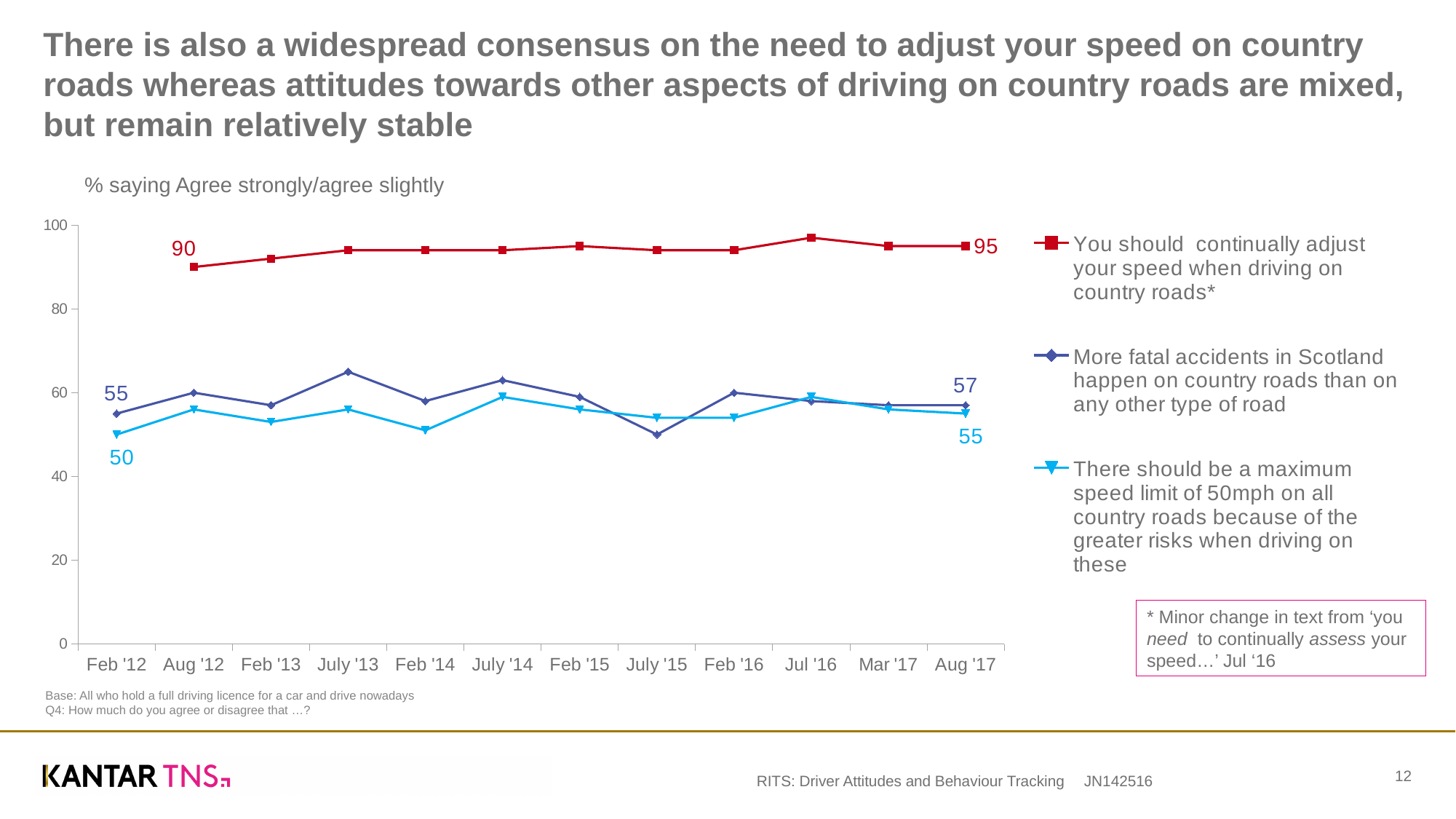
What value does the 'More fatal accidents in Scotland happen on country roads' series have at Aug '17? 57 What value does the 'There should be a maximum speed limit of 50mph on all country roads' series have at Aug '17? 55 What value does the 'There should be a maximum speed limit of 50mph on all country roads' series have at Feb '12? 50 By how much did the 'You should continually adjust your speed' series change between Aug '12 and Aug '17? 5 Is the value for 'More fatal accidents in Scotland happen on country roads' at July '13 greater or less than 60? greater What kind of chart is shown on the slide? Line chart How many series does the legend list? 3 What value does the 'You should continually adjust your speed when driving on country roads' series have at Aug '12? 90 At Aug '17, which series is higher: 'More fatal accidents in Scotland happen on country roads' or 'There should be a maximum speed limit of 50mph'? More fatal accidents in Scotland happen on country roads What value does the 'More fatal accidents in Scotland happen on country roads than on any other type of road' series have at Feb '12? 55 What value does the 'You should continually adjust your speed when driving on country roads' series have at Aug '17? 95 How many time points are shown on the x axis? 12